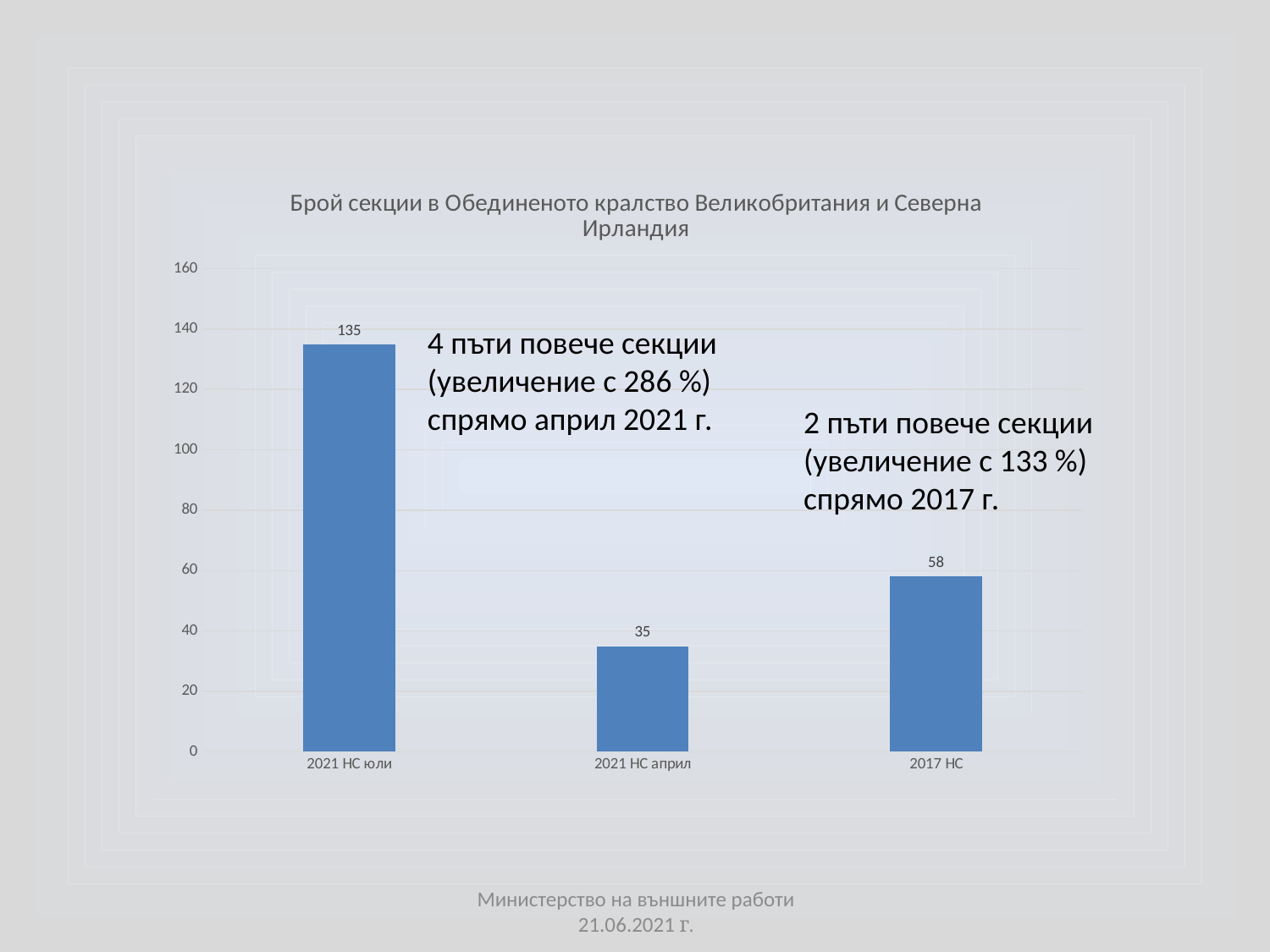
What is the difference between the values for 2017 НС and 2021 НС април? 23 What is the value for 2017 НС? 58 What is the value for 2021 НС април? 35 Which category has the highest value? 2021 НС юли What is the title of the chart? Брой секции в Обединеното кралство Великобритания и Северна Ирландия Which category has the lowest value? 2021 НС април How many categories are shown on the x axis? 3 What is the difference between the values for 2021 НС юли and 2021 НС април? 100 What is the value for 2021 НС юли? 135 What kind of chart is shown on the slide? bar chart Which is larger, the value for 2017 НС or the value for 2021 НС април? 2017 НС Is the value for 2021 НС юли greater or less than 120? greater